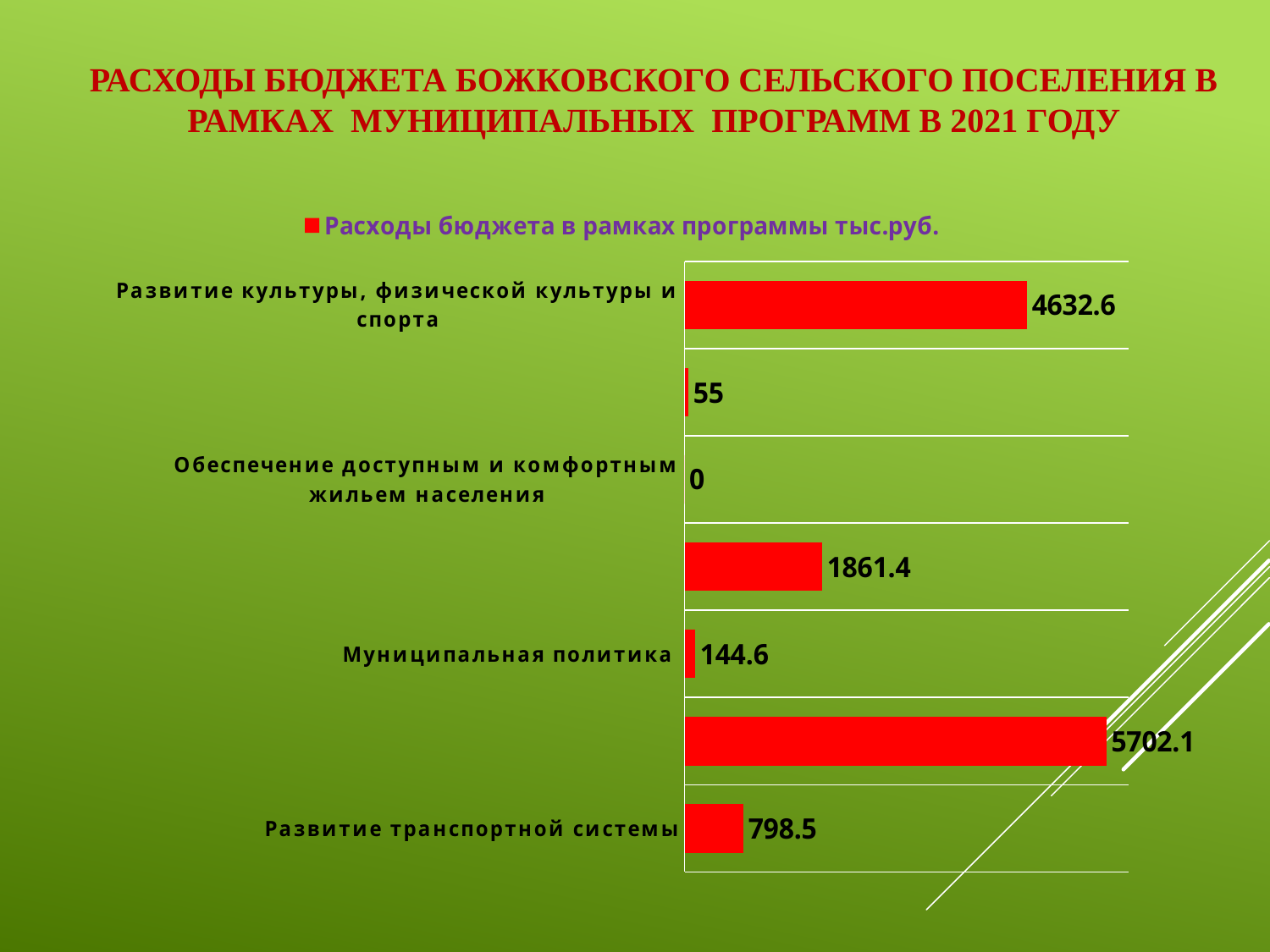
What is the difference between the values for «Развитие культуры, физической культуры и спорта» and «Развитие транспортной системы»? 3834.1 How many bars (data points) are plotted on the chart? 7 How many series does the legend list? 1 What is the value for «Развитие культуры, физической культуры и спорта»? 4632.6 Which is larger: the value for «Муниципальная политика» or for «Развитие транспортной системы»? Развитие транспортной системы What is the value for «Развитие транспортной системы»? 798.5 What is the value for «Муниципальная политика»? 144.6 What kind of chart is shown on the slide? bar chart Which labelled category has the lowest value? Обеспечение доступным и комфортным жильем населения What is the largest value shown on the chart? 5702.1 What is the value for «Обеспечение доступным и комфортным жильем населения»? 0 What is the difference between the values for «Развитие транспортной системы» and «Муниципальная политика»? 653.9